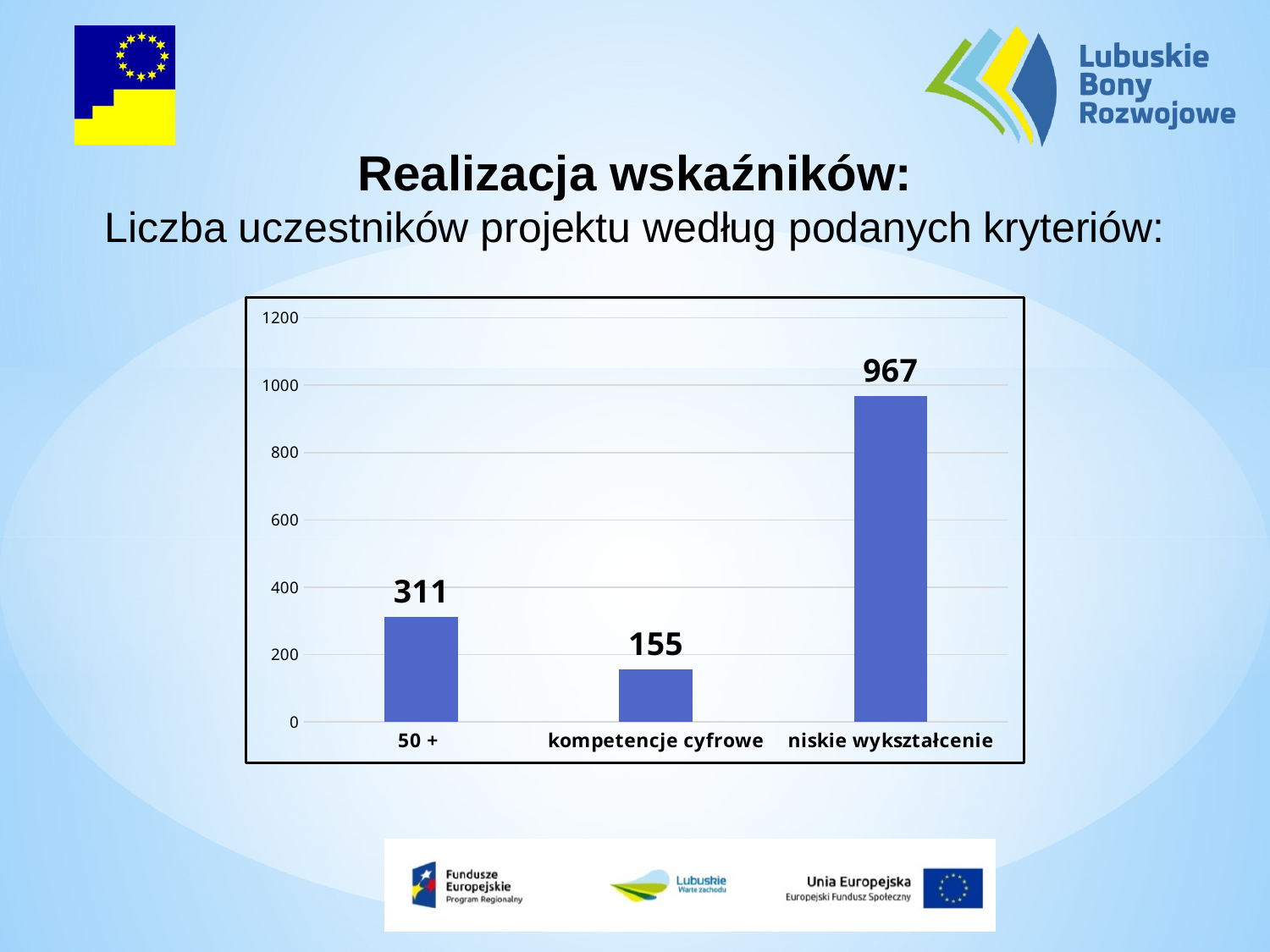
What is the difference between the values for "50 +" and "kompetencje cyfrowe"? 156 What is the value for the category "50 +"? 311 What is the highest value shown on the vertical axis? 1200 What is the difference between the values for "niskie wykształcenie" and "50 +"? 656 What is the value for "kompetencje cyfrowe"? 155 What kind of chart is shown on the slide? bar chart Which category has the highest value? niskie wykształcenie Which category has the lowest value? kompetencje cyfrowe How many categories are shown on the chart? 3 Is the value for "niskie wykształcenie" greater or less than 800? greater What is the value for "niskie wykształcenie"? 967 Which is larger, the value for "50 +" or the value for "kompetencje cyfrowe"? 50 +